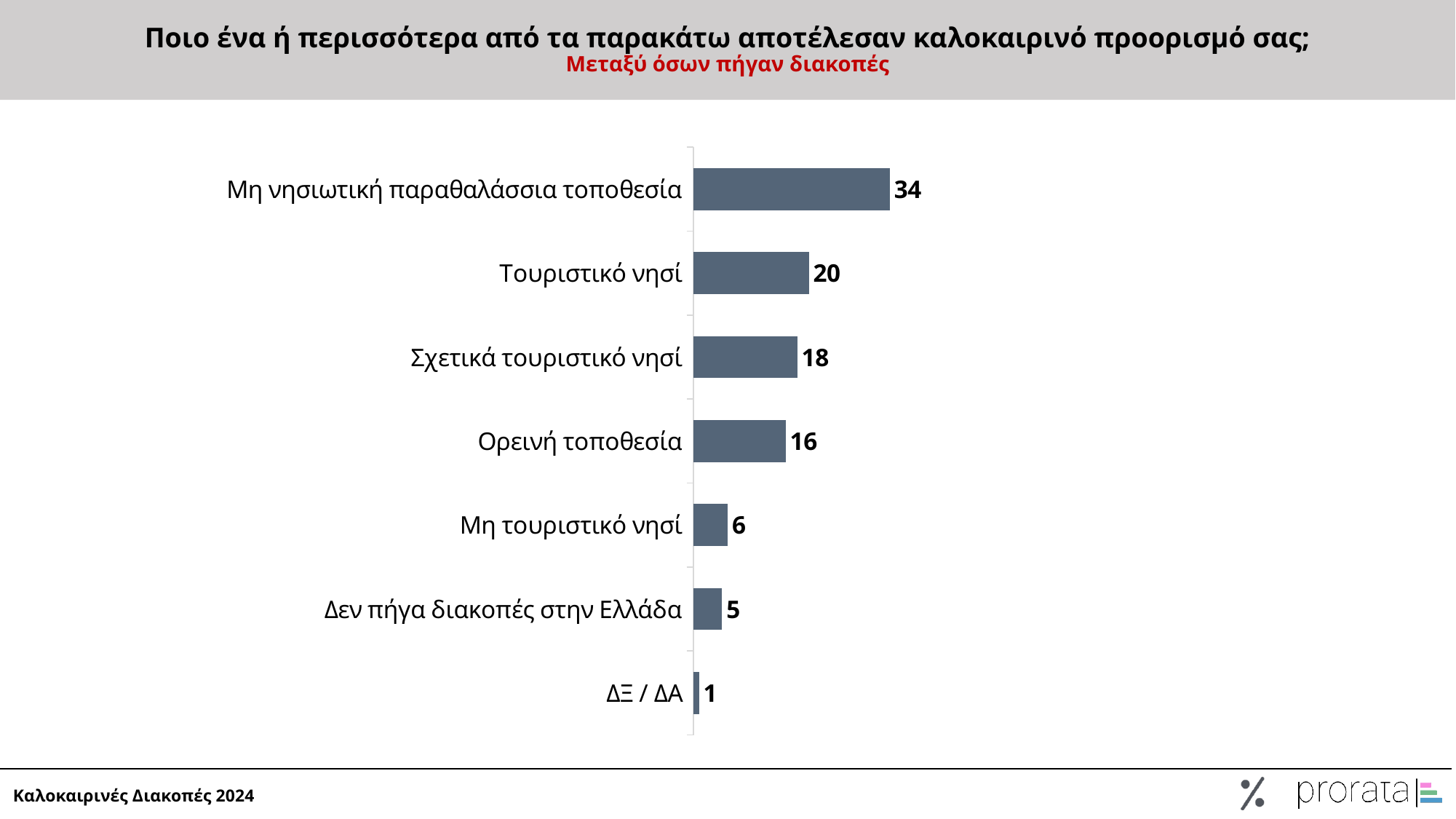
What is the red subtitle text under the chart title? Μεταξύ όσων πήγαν διακοπές What is the difference between the values for Τουριστικό νησί and Σχετικά τουριστικό νησί? 2 What is the value for Μη νησιωτική παραθαλάσσια τοποθεσία? 34 What is the difference between the values for Μη νησιωτική παραθαλάσσια τοποθεσία and Ορεινή τοποθεσία? 18 What is the value for Τουριστικό νησί? 20 Which category has the lowest value? ΔΞ / ΔΑ Which is larger, the value for Μη τουριστικό νησί or the value for Δεν πήγα διακοπές στην Ελλάδα? Μη τουριστικό νησί What kind of chart is shown on the slide? Bar chart What is the value for Ορεινή τοποθεσία? 16 What is the value for Δεν πήγα διακοπές στην Ελλάδα? 5 How many categories are shown in the chart? 7 Which category has the highest value? Μη νησιωτική παραθαλάσσια τοποθεσία